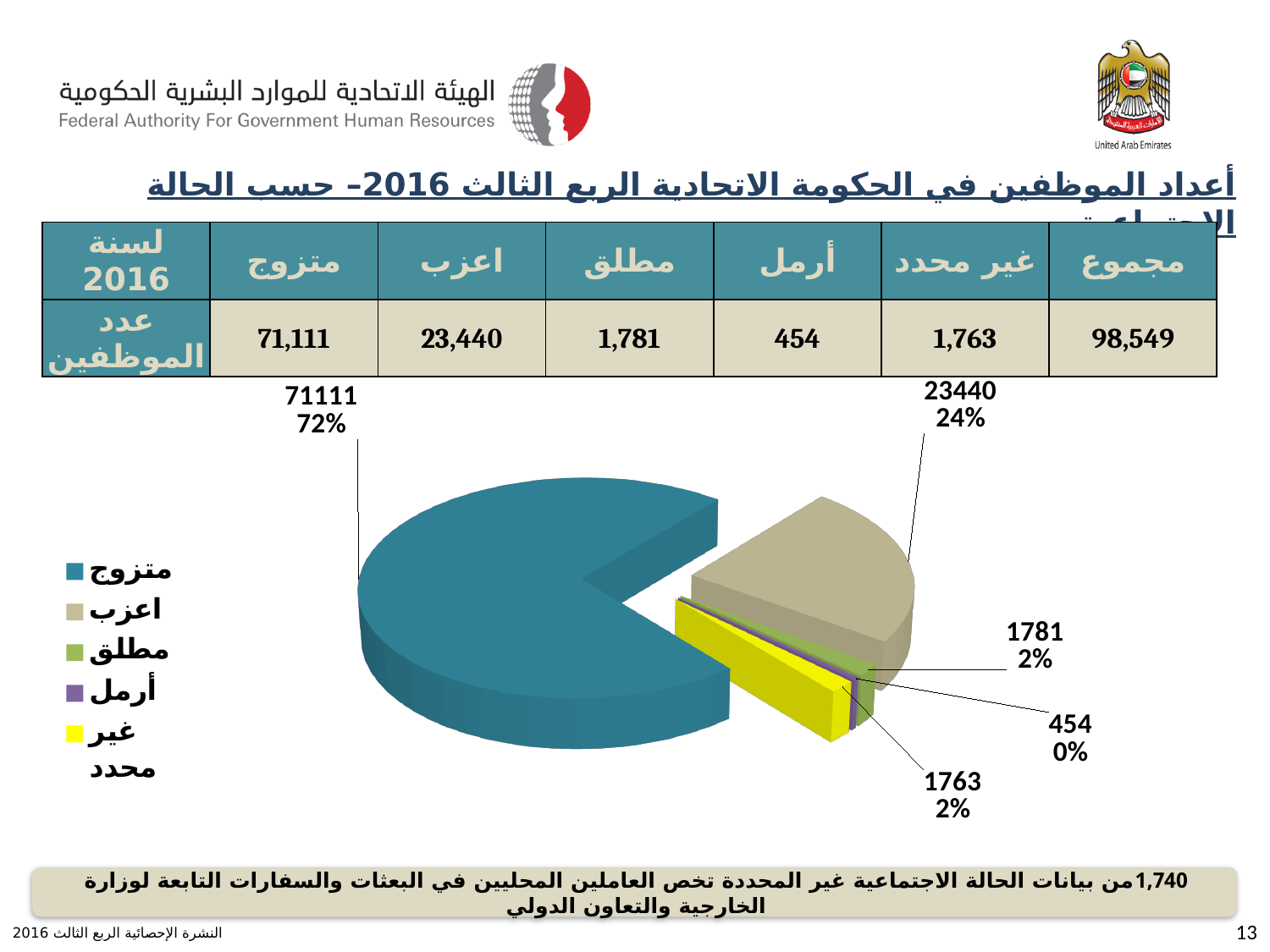
What value is labelled on the pie chart for اعزب (single)? 23440 What percentage share does the pie chart show for اعزب (single)? 24% How many slices does the pie chart have? 5 What value is labelled on the pie chart for أرمل (widowed)? 454 What is the difference between the values for متزوج (71111) and اعزب (23440) in the pie chart? 47671 Which category has the smallest slice in the pie chart? أرمل Which is larger in the pie chart, the value for مطلق or the value for أرمل? مطلق What percentage share does the pie chart show for متزوج (married)? 72% How many entries does the legend of the pie chart list? 5 Which category has the largest slice in the pie chart? متزوج What value is labelled on the pie chart for متزوج (married)? 71111 What kind of chart is shown on the slide? pie chart